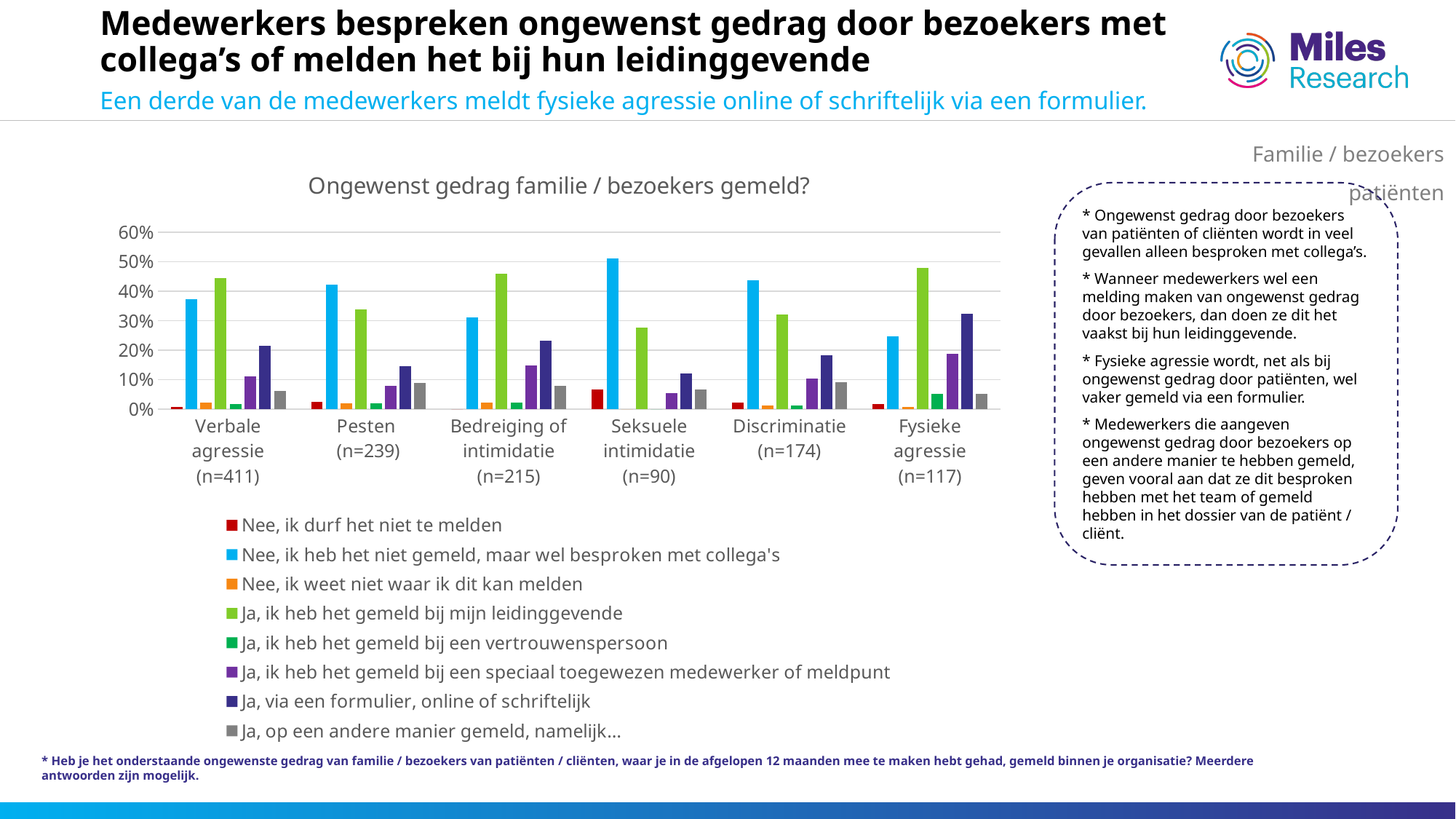
What kind of chart is shown on the slide? bar chart Is the value for 'Ja, via een formulier, online of schriftelijk' for Fysieke agressie greater or less than 20%? greater How many categories of unwanted behaviour are shown on the x axis of the chart? 6 For which category is the 'Nee, ik heb het niet gemeld, maar wel besproken met collega's' bar the highest? Seksuele intimidatie Is the value for 'Nee, ik heb het niet gemeld, maar wel besproken met collega's' for Seksuele intimidatie greater or less than 40%? greater For which category is the 'Ja, via een formulier, online of schriftelijk' bar the highest? Fysieke agressie What is the title of the chart? Ongewenst gedrag familie / bezoekers gemeld? Is the value for 'Ja, ik heb het gemeld bij mijn leidinggevende' for Fysieke agressie greater or less than 40%? greater How many series does the chart's legend list? 8 For Verbale agressie, which is larger: 'Nee, ik heb het niet gemeld, maar wel besproken met collega's' or 'Ja, ik heb het gemeld bij mijn leidinggevende'? Ja, ik heb het gemeld bij mijn leidinggevende For Pesten, which is larger: 'Nee, ik heb het niet gemeld, maar wel besproken met collega's' or 'Ja, ik heb het gemeld bij mijn leidinggevende'? Nee, ik heb het niet gemeld, maar wel besproken met collega's